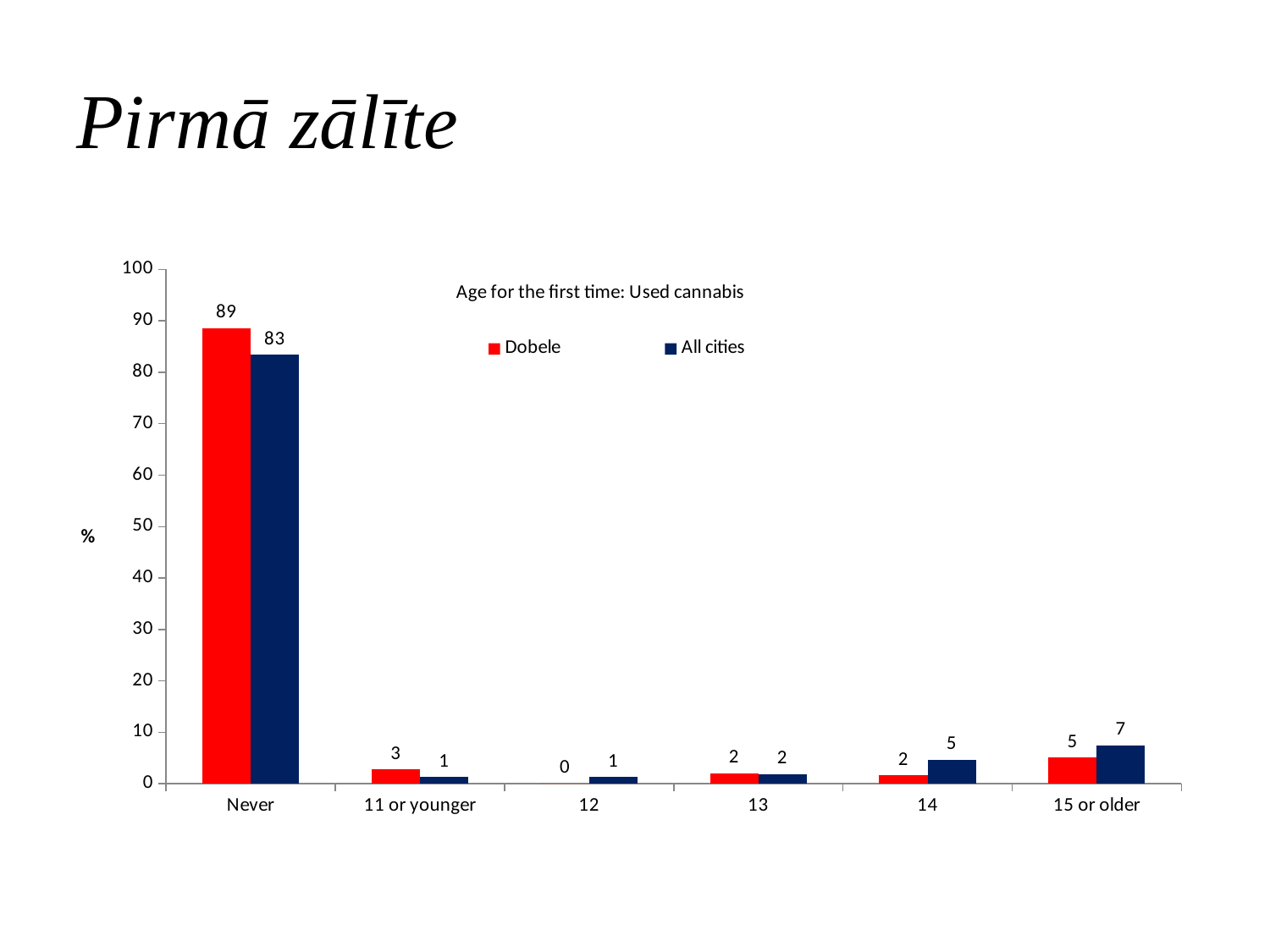
What is the difference between the Dobele and All cities values in the Never category? 6 Which category has the highest value for Dobele? Never What is the value for Dobele in the Never category? 89 What is the value for All cities in the 14 category? 5 What kind of chart is shown on the slide? Bar chart What is the value for Dobele in the 12 category? 0 What is the value for All cities in the 15 or older category? 7 How many age categories are shown on the x axis? 6 Which category has the lowest value for Dobele? 12 How many series does the legend list? 2 What is the title of the chart? Age for the first time: Used cannabis In the 14 category, which series has the larger value, Dobele or All cities? All cities